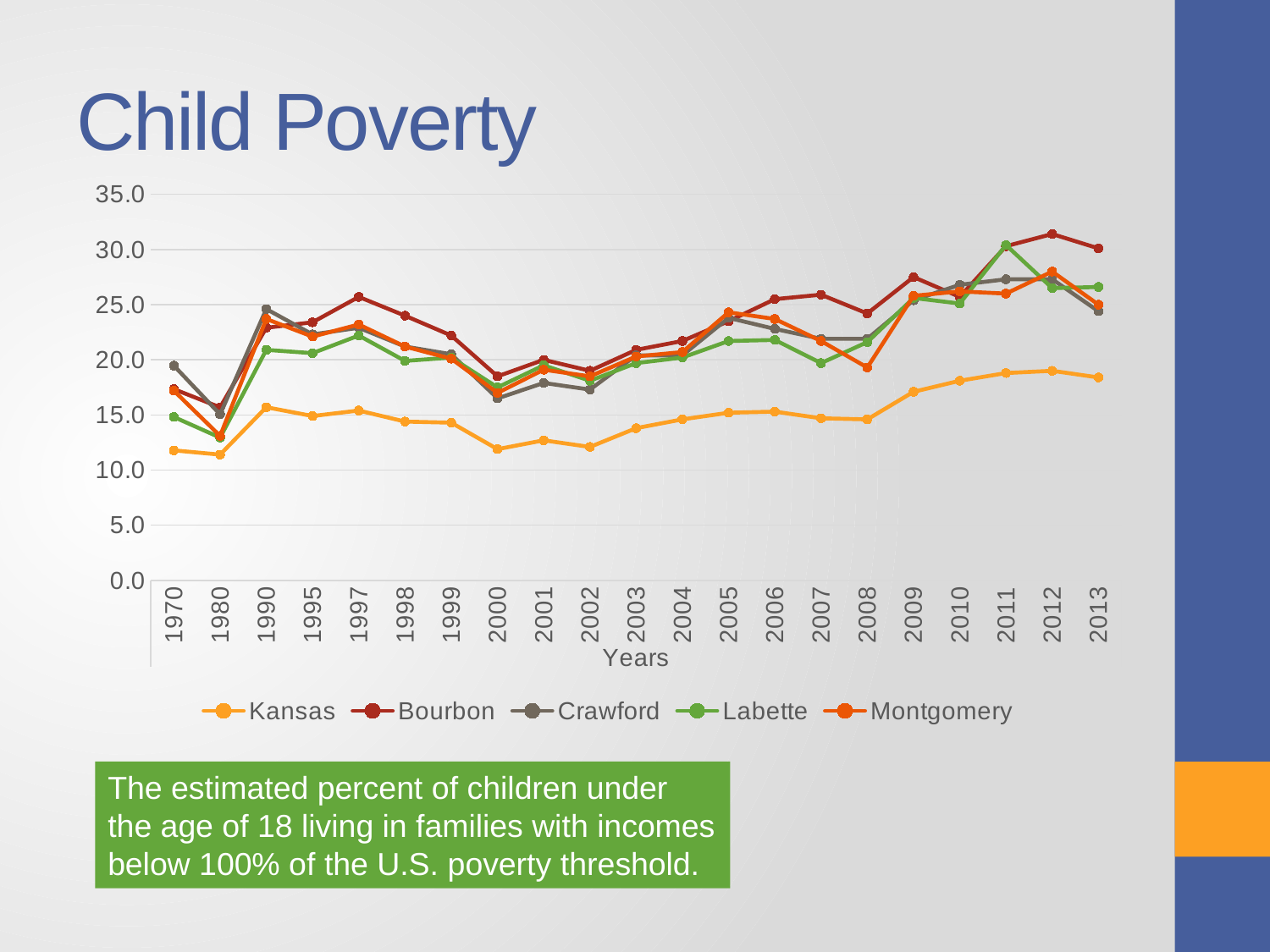
How many series does the legend of the Child Poverty chart list? 5 Which is larger in 2012: the value for Bourbon or the value for Crawford? Bourbon What is the title of the x axis on the Child Poverty chart? Years Does the Kansas line rise or fall between 2008 and 2012? rise Is the value for Crawford in 1990 greater or less than 20.0? greater Which series has the lowest value in every year of the Child Poverty chart? Kansas Is the value for Bourbon in 2012 greater or less than 30.0? greater What kind of chart is shown on the Child Poverty slide? line chart Which series has the highest value in 2013 on the Child Poverty chart? Bourbon Is the value for Kansas in 2013 greater or less than 20.0? less How many years are shown along the x axis of the Child Poverty chart? 21